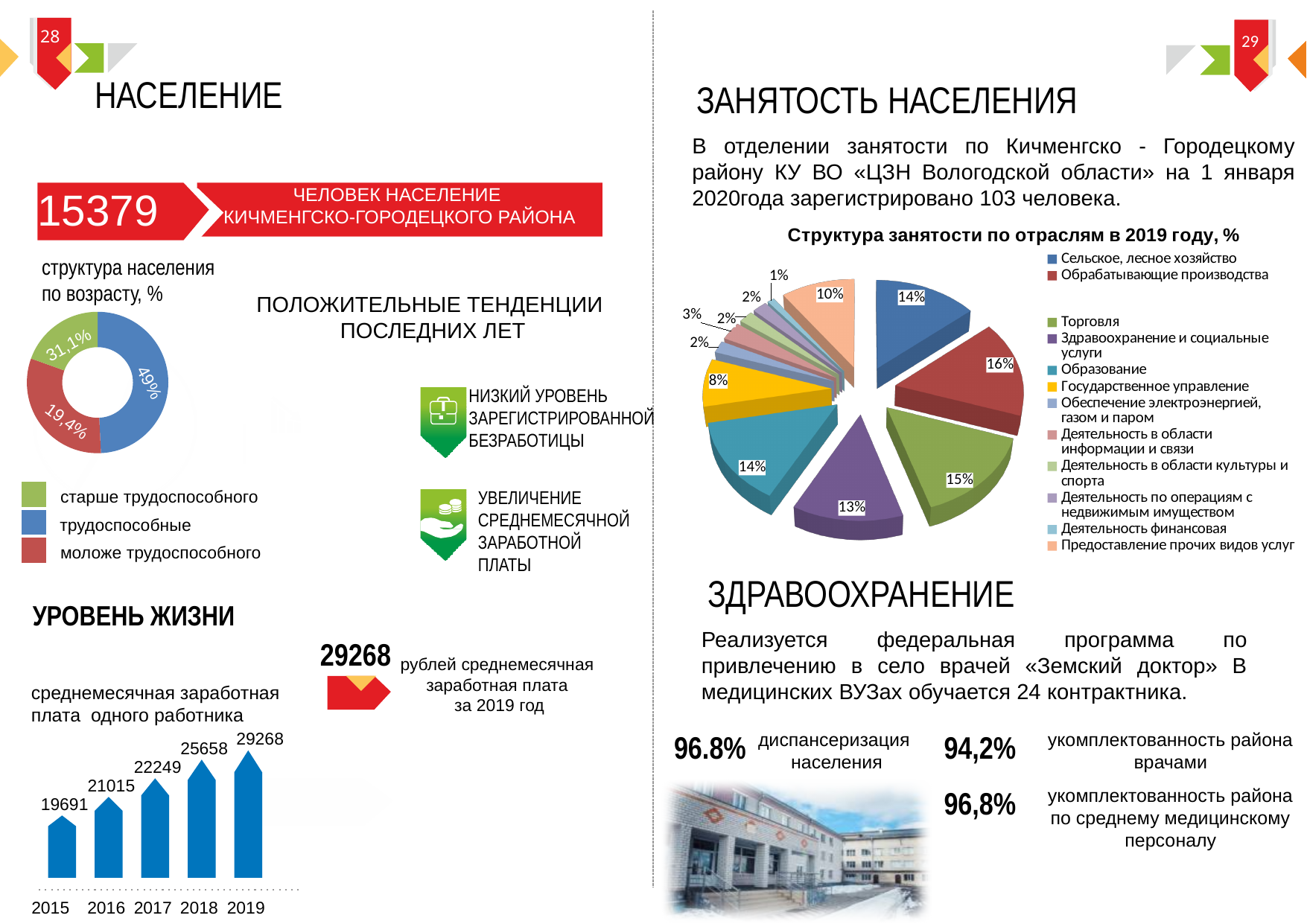
In the donut chart of population structure by age, what share is трудоспособные? 49% In the bar chart of average monthly salary per worker, what is the value for 2019? 29268 In the bar chart of average monthly salary per worker, do the values rise or fall from 2015 to 2019? rise In the pie chart 'Структура занятости по отраслям в 2019 году, %', which is larger: Торговля or Здравоохранение и социальные услуги? Торговля What kind of chart is used to show the average monthly salary per worker? bar chart In the bar chart of average monthly salary per worker, what is the value for 2015? 19691 In the bar chart of average monthly salary per worker, how much higher is the 2018 value than the 2017 value? 3409 In the pie chart 'Структура занятости по отраслям в 2019 году, %', which industry has the largest share? Обрабатывающие производства How many years are shown in the bar chart of average monthly salary per worker? 5 In the pie chart 'Структура занятости по отраслям в 2019 году, %', what is the share for Обрабатывающие производства? 16% In the donut chart of population structure by age, which group has the smallest share? моложе трудоспособного In the donut chart of population structure by age, what is the share for старше трудоспособного? 31,1%